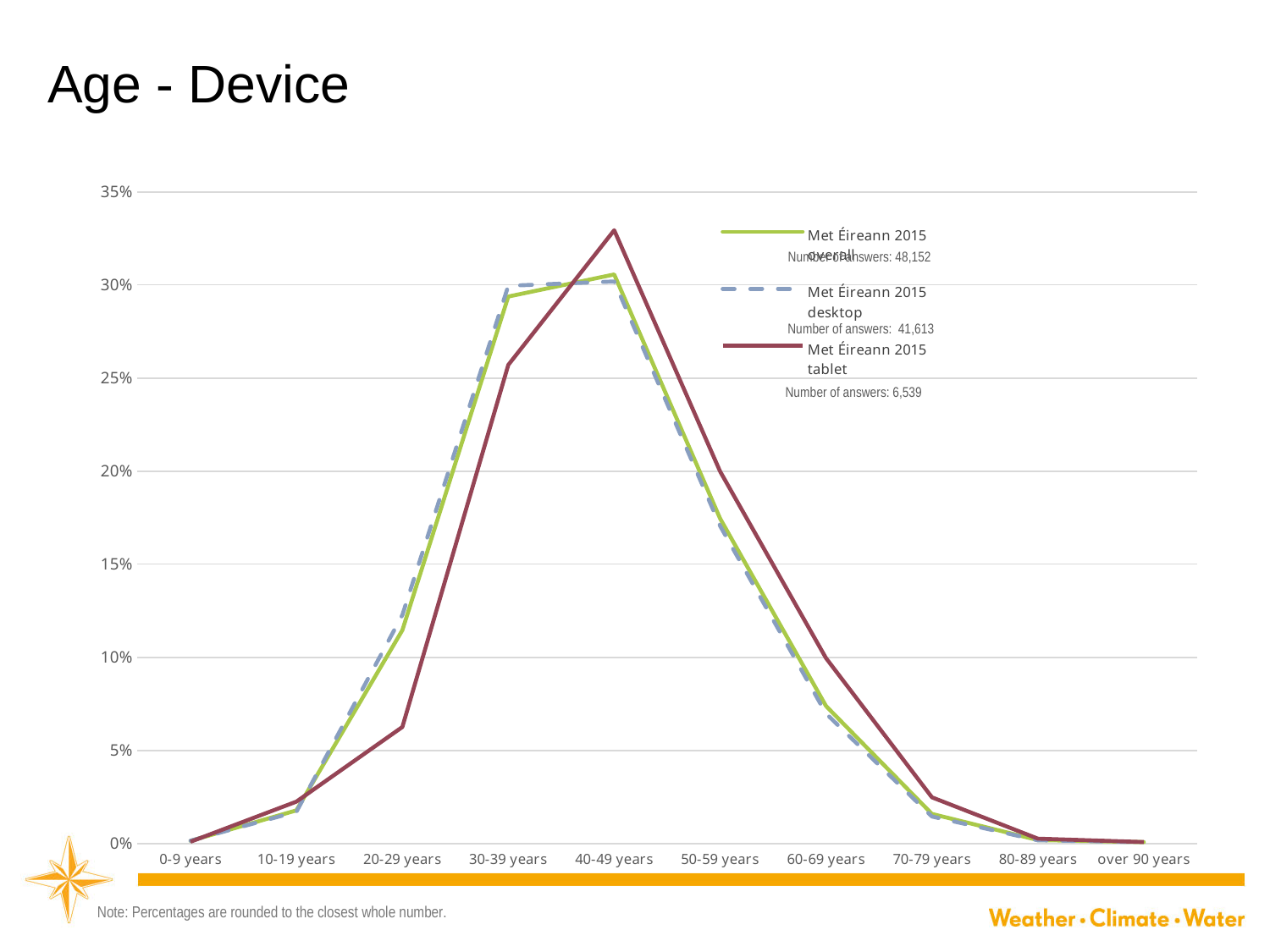
Do the values for Met Éireann 2015 tablet rise or fall from 40-49 years to over 90 years? fall At 20-29 years, which series has the larger value: Met Éireann 2015 desktop or Met Éireann 2015 tablet? Met Éireann 2015 desktop According to the legend annotation, how many answers were there for Met Éireann 2015 tablet? 6,539 Is the value for Met Éireann 2015 tablet at 20-29 years greater or less than 10%? less How many series does the legend list? 3 Is the value for Met Éireann 2015 overall at 30-39 years greater or less than 25%? greater Which age group has the highest value for the Met Éireann 2015 tablet series? 40-49 years Is the value for Met Éireann 2015 tablet at 40-49 years greater or less than 30%? greater What kind of chart is shown on the slide? line chart At 40-49 years, which series has the larger value: Met Éireann 2015 tablet or Met Éireann 2015 overall? Met Éireann 2015 tablet How many age groups are shown on the x axis? 10